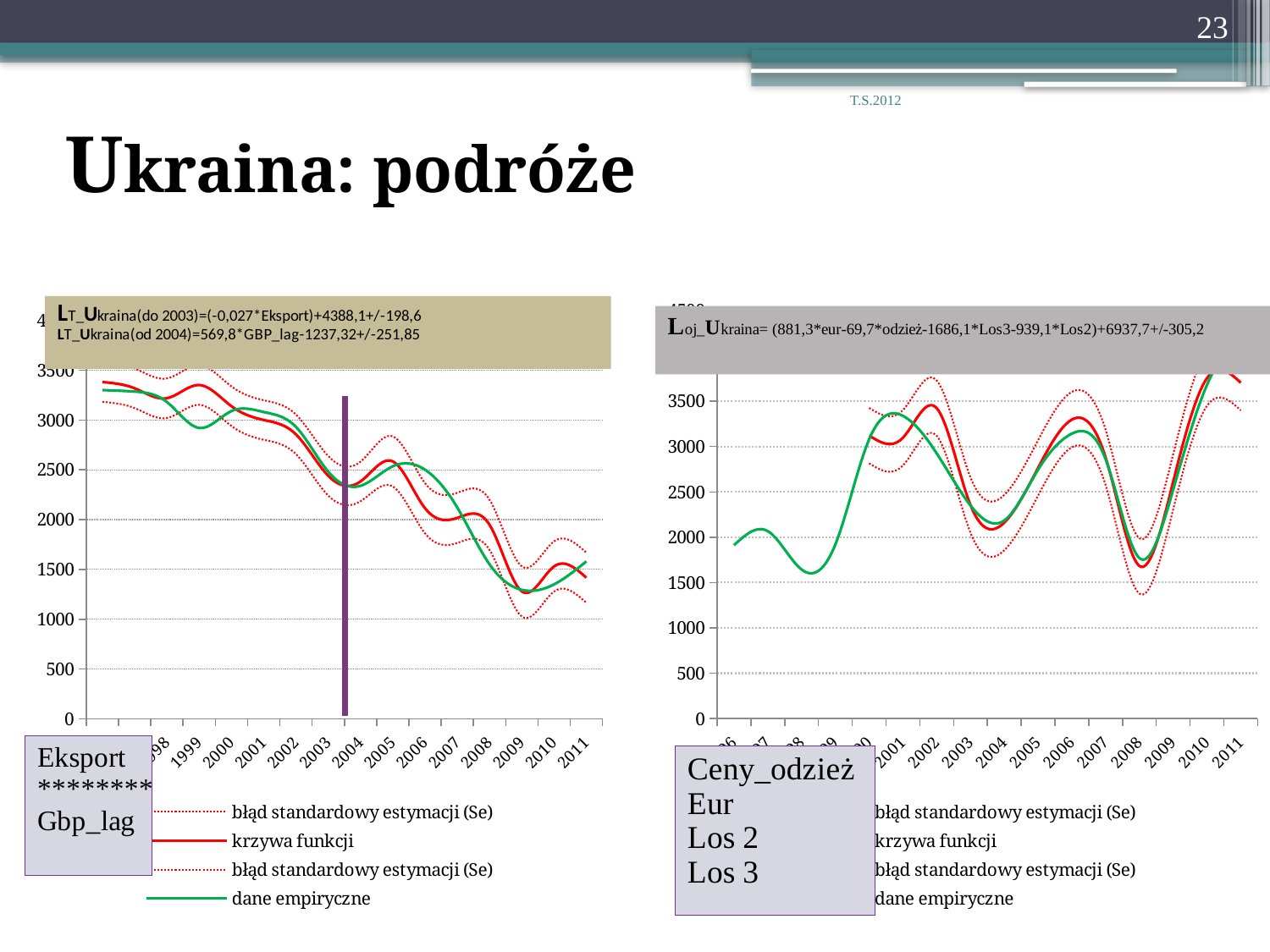
In the left chart (LT_Ukraina), at which year is the vertical purple line drawn? 2004 In the left chart (LT_Ukraina), is the 'dane empiryczne' value for 2009 greater or less than 1500? less In the left chart (LT_Ukraina), is the 'dane empiryczne' value for 1998 greater or less than 3000? greater In the left chart (LT_Ukraina), how many entries does the legend list? 4 In the right chart (Loj_Ukraina), is the 'dane empiryczne' value for 2010 greater or less than 3000? greater In the left chart (LT_Ukraina), does the 'dane empiryczne' line generally rise or fall from 1998 to 2011? fall In the right chart (Loj_Ukraina), how many entries does the legend list? 4 What type of chart is the right chart (Loj_Ukraina)? line chart What type of chart is the left chart (LT_Ukraina)? line chart In the left chart (LT_Ukraina), which legend entry is drawn as a solid green line? dane empiryczne